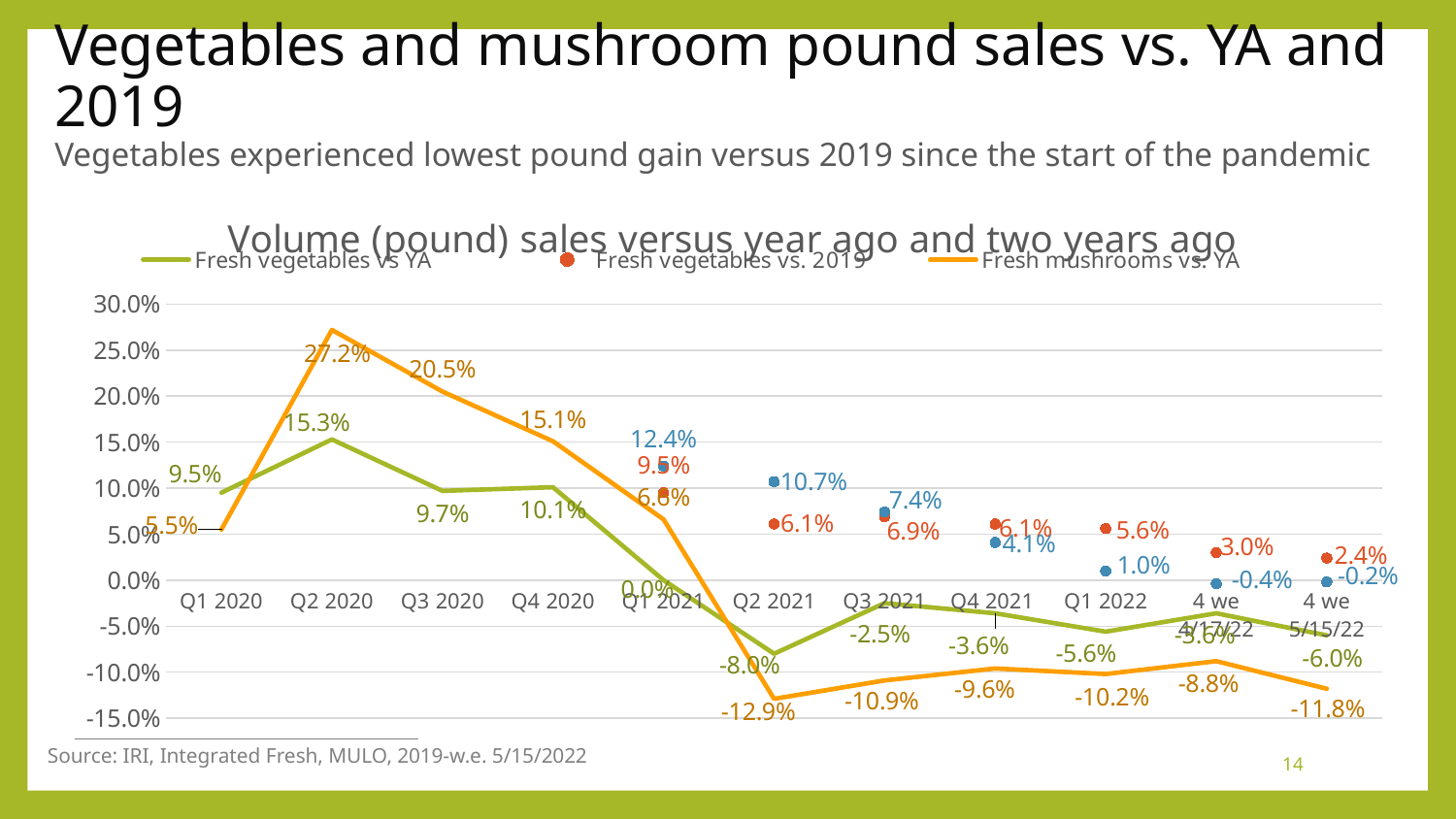
What is the value for Fresh mushrooms vs. YA in Q2 2020? 27.2% In Q4 2020, which is larger: Fresh vegetables vs YA or Fresh mushrooms vs. YA? Fresh mushrooms vs. YA How many series does the chart legend list? 3 What is the difference between the Fresh mushrooms vs. YA values for Q2 2020 and Q3 2020? 6.7 percentage points In which period is Fresh mushrooms vs. YA lowest? Q2 2021 In which period is Fresh vegetables vs YA lowest? Q2 2021 In which period is Fresh mushrooms vs. YA highest? Q2 2020 What kind of chart is shown on the slide? Line chart What is the value for Fresh vegetables vs. 2019 for the 4 weeks ending 5/15/22? 2.4% What is the value for Fresh vegetables vs YA in Q2 2020? 15.3% What is the value for Fresh vegetables vs YA for the 4 weeks ending 5/15/22? -6.0% How many time periods are shown on the x axis? 11